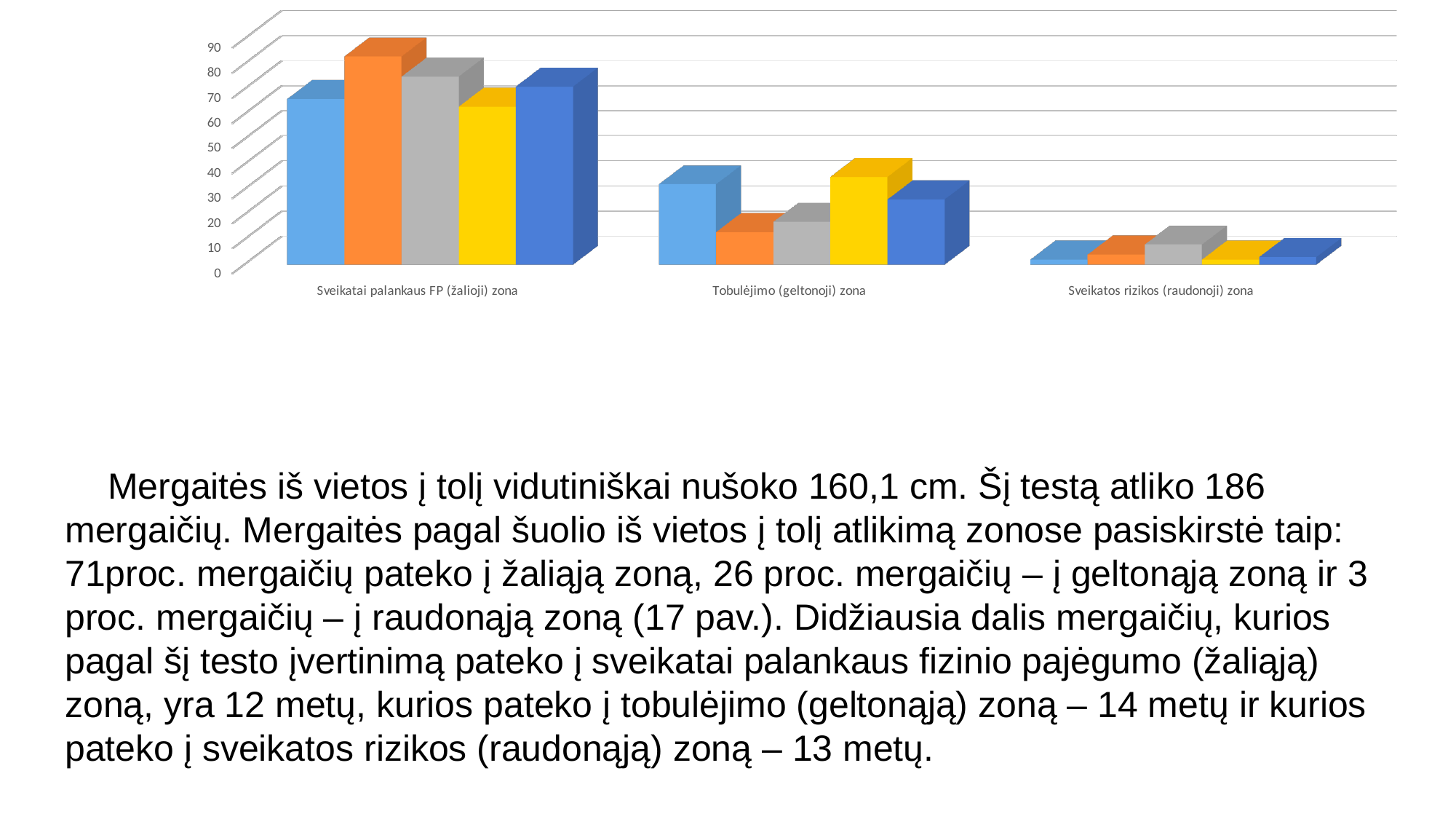
Is the value of the orange bar for Tobulėjimo (geltonoji) zona greater or less than 30? less How many categories are shown on the x axis of the chart? 3 What kind of chart is shown on the slide? bar chart Is the value of the orange bar for Sveikatai palankaus FP (žalioji) zona greater or less than 60? greater Which category has the lowest bars in the chart? Sveikatos rizikos (raudonoji) zona Which category has the tallest bars in the chart? Sveikatai palankaus FP (žalioji) zona What is the highest value labelled on the vertical axis of the chart? 90 Which category has the larger light blue bar: Sveikatai palankaus FP (žalioji) zona or Tobulėjimo (geltonoji) zona? Sveikatai palankaus FP (žalioji) zona Do the bar heights rise or fall moving from the left category to the right category? fall How many bars are plotted for each category in the chart? 5 Are all the bars for Sveikatos rizikos (raudonoji) zona greater or less than 20? less What is the label of the middle category on the x axis? Tobulėjimo (geltonoji) zona